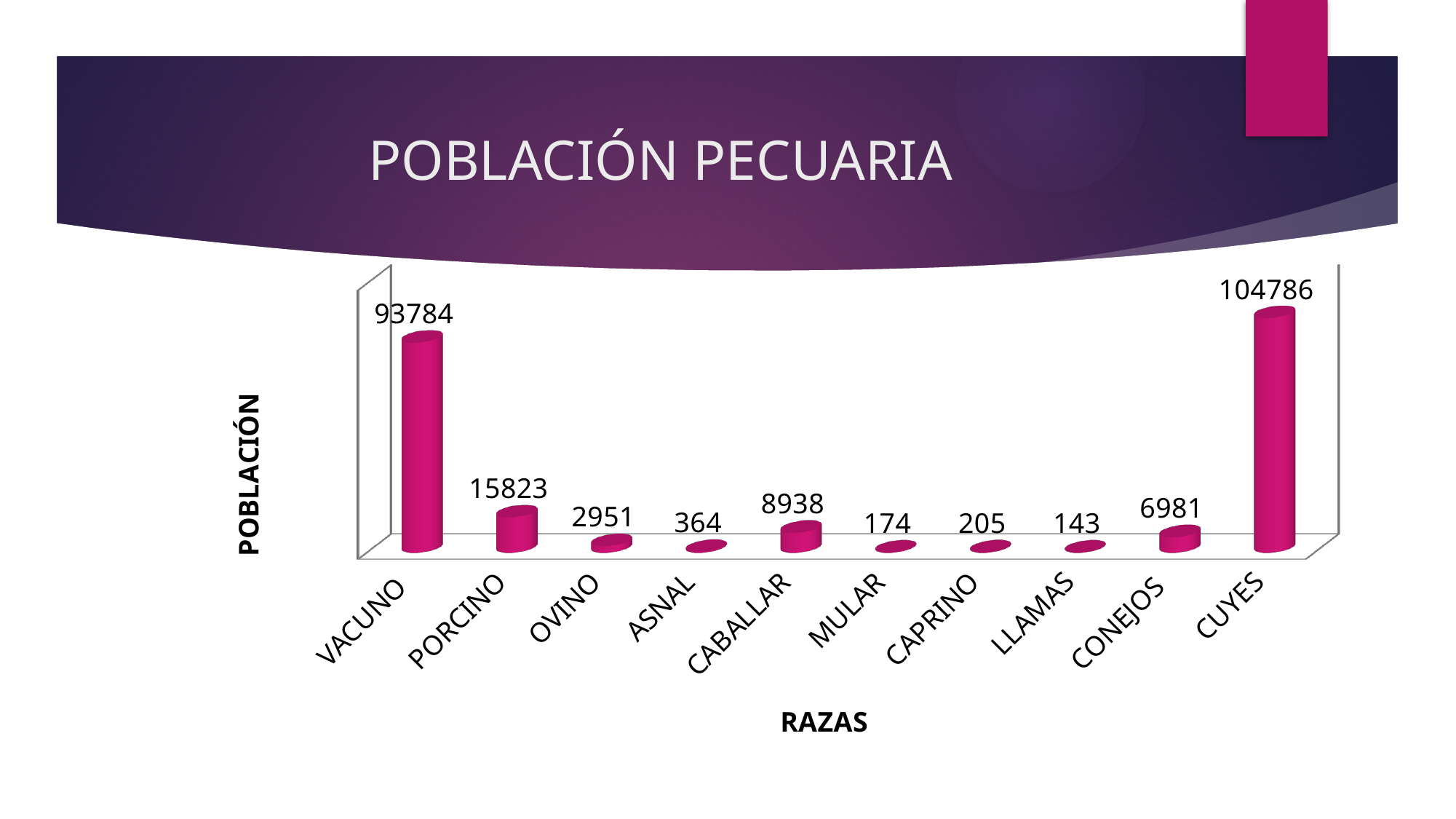
What kind of chart is shown on the slide? Bar chart Which category has the lowest value? LLAMAS What is the difference between the values for CUYES and VACUNO? 11002 How many categories are shown on the x axis? 10 What is the label of the x axis? RAZAS What is the value for VACUNO? 93784 Which category has the highest value? CUYES What is the value for CABALLAR? 8938 Which is larger, the value for CAPRINO or the value for MULAR? CAPRINO What is the value for LLAMAS? 143 What is the value for CUYES? 104786 What is the difference between the values for PORCINO and CONEJOS? 8842